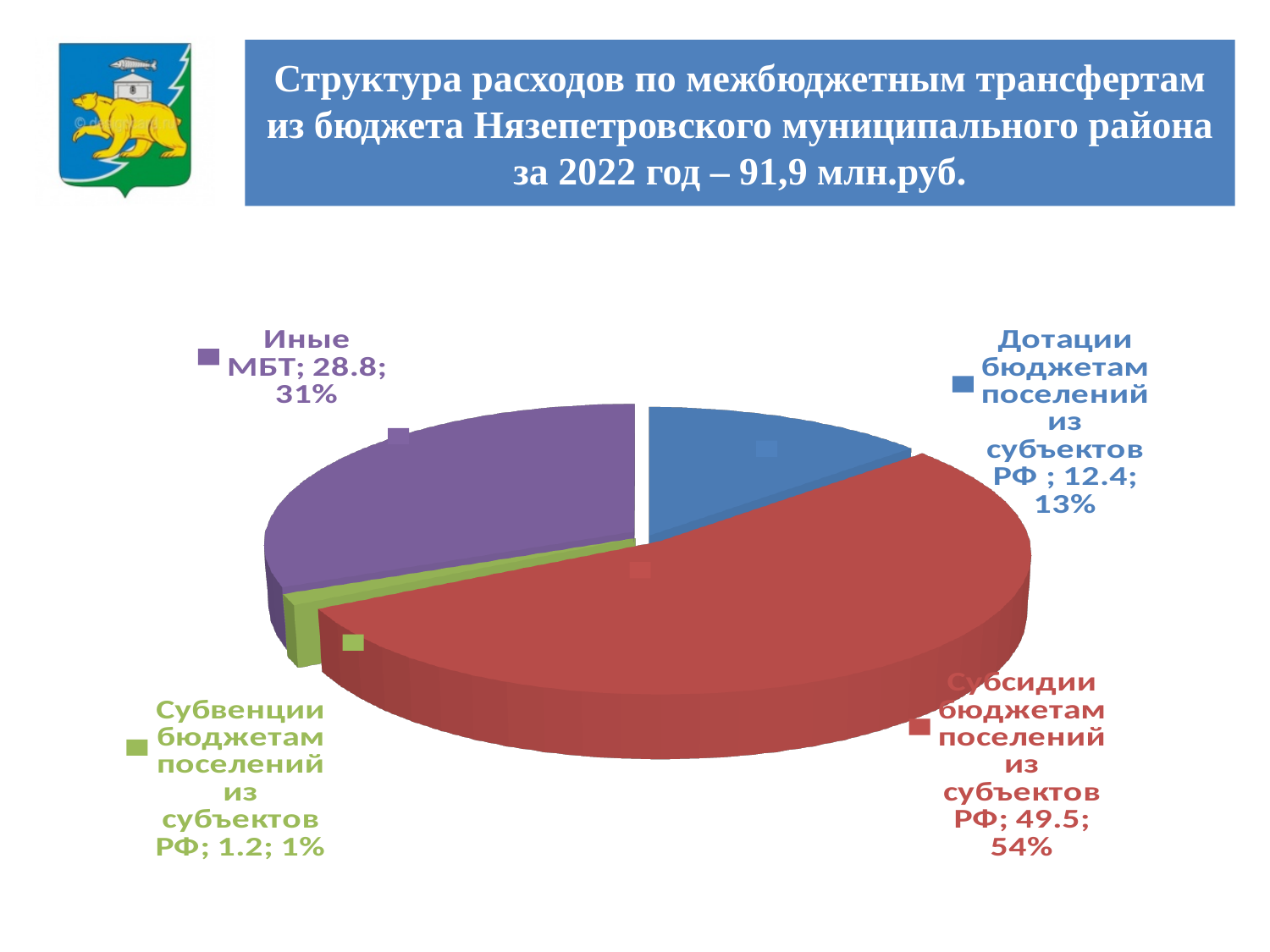
What share of the pie does "Иные МБТ" represent? 31% What is the difference between the values for "Субсидии бюджетам поселений из субъектов РФ" and "Иные МБТ"? 20.7 What is the value shown for "Иные МБТ"? 28.8 Which category has the smallest slice? Субвенции бюджетам поселений из субъектов РФ What share of the pie does "Субсидии бюджетам поселений из субъектов РФ" represent? 54% What is the value shown for "Дотации бюджетам поселений из субъектов РФ"? 12.4 Which is larger: the value for "Дотации бюджетам поселений из субъектов РФ" or for "Иные МБТ"? Иные МБТ What is the value shown for "Субвенции бюджетам поселений из субъектов РФ"? 1.2 What type of chart is shown on the slide? pie chart What is the value shown for "Субсидии бюджетам поселений из субъектов РФ"? 49.5 How many slices does the pie chart have? 4 Which category has the largest slice? Субсидии бюджетам поселений из субъектов РФ